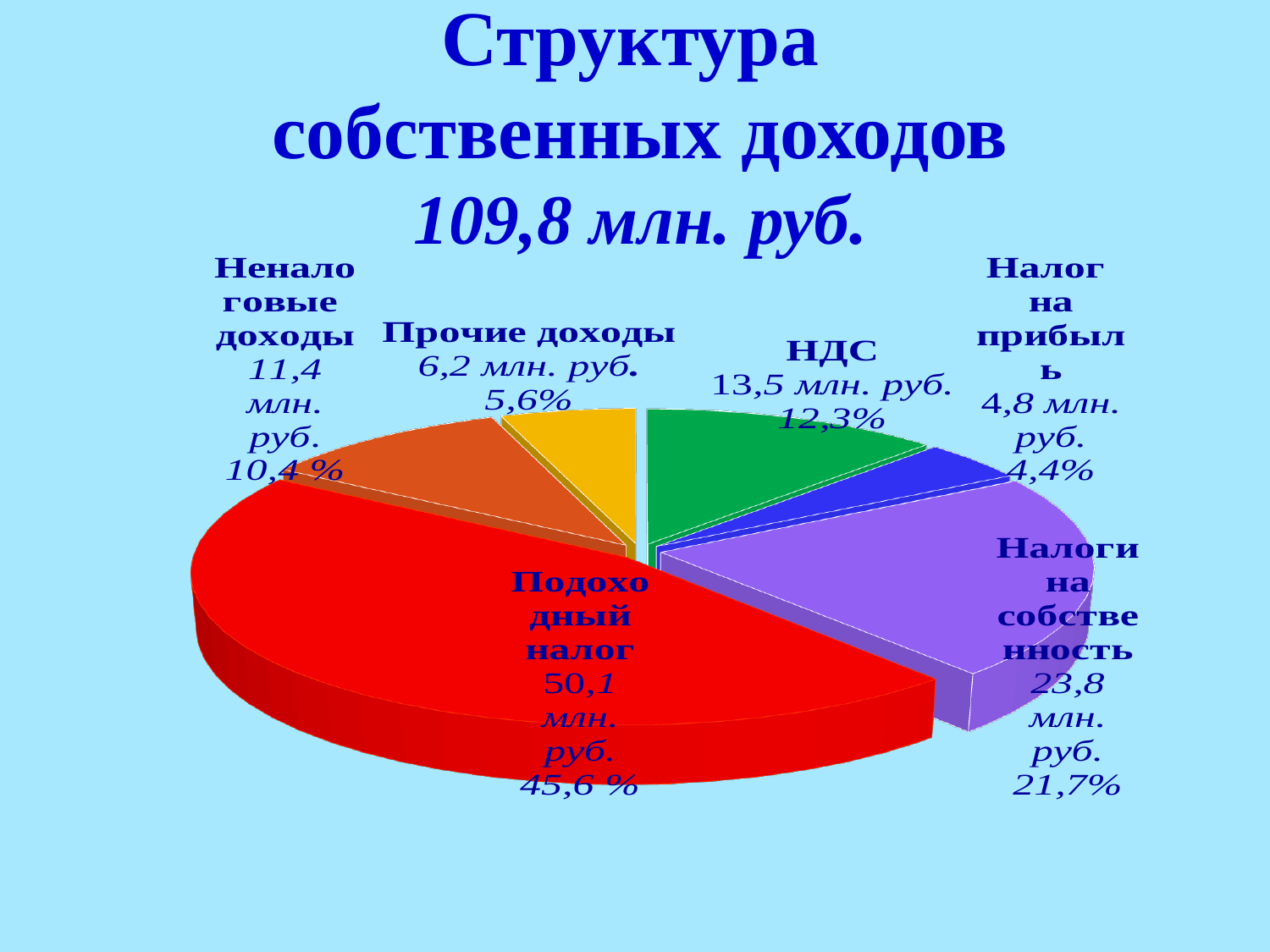
What kind of chart is shown on the slide? pie chart What total amount is stated in the chart title? 109,8 млн. руб. Which category has the smallest slice of the pie? Налог на прибыль What is the value for Подоходный налог in млн. руб.? 50,1 млн. руб. What share of the pie does НДС represent? 12,3% What colour is the slice for Подоходный налог? red Which category has the largest slice of the pie? Подоходный налог What share of the pie does Налог на прибыль represent? 4,4% How many slices does the pie chart have? 6 What is the value for Налоги на собственность in млн. руб.? 23,8 млн. руб. What is the difference in млн. руб. between Налоги на собственность and НДС? 10,3 млн. руб. Which is larger, Неналоговые доходы or Прочие доходы? Неналоговые доходы